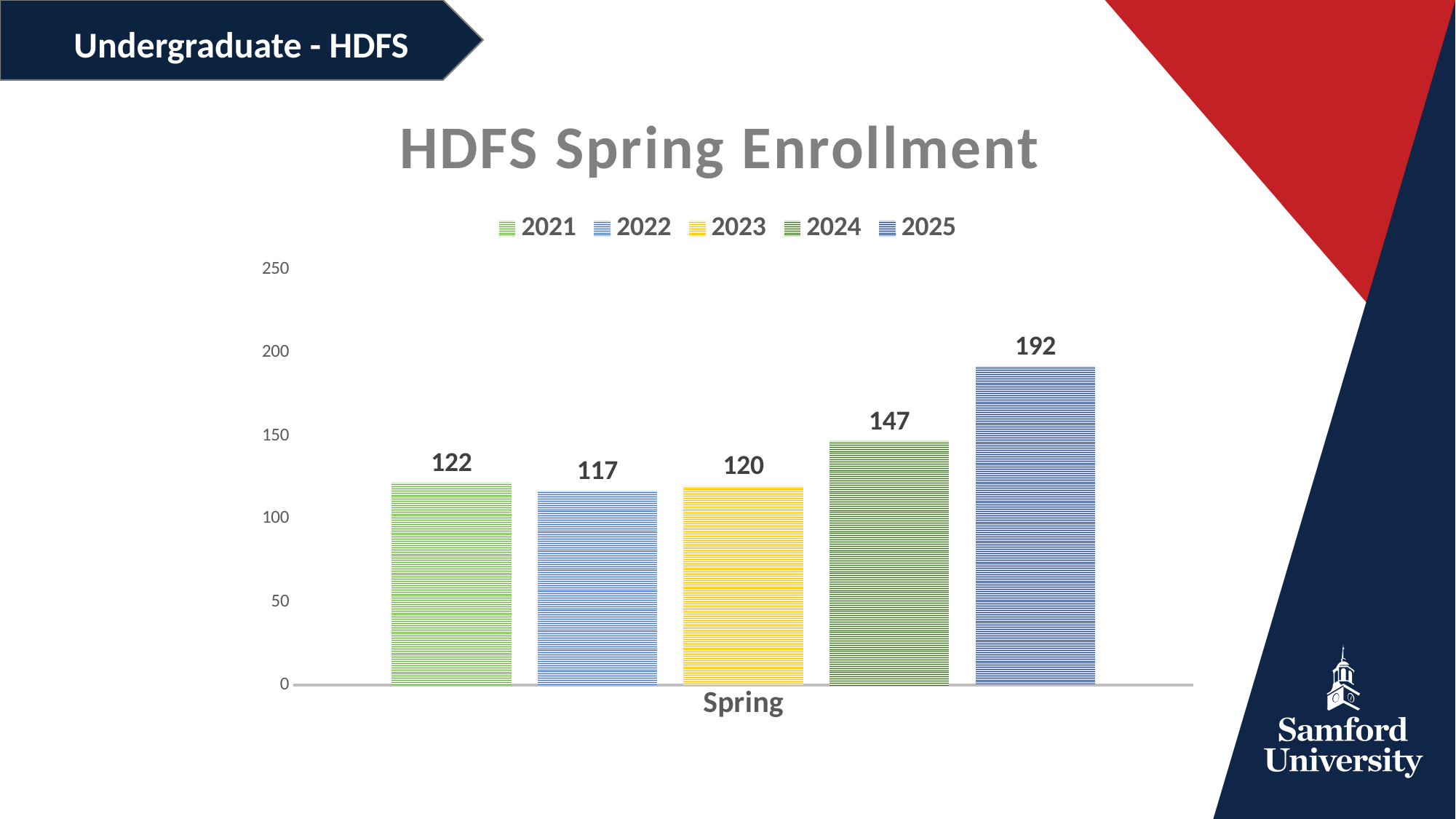
Is the HDFS Spring enrollment for 2024 greater or less than 150? less What is the difference in HDFS Spring enrollment between 2025 and 2024? 45 Which year has the lowest HDFS Spring enrollment? 2022 What is the HDFS Spring enrollment for 2024? 147 What is the difference in HDFS Spring enrollment between 2021 and 2023? 2 What is the HDFS Spring enrollment for 2022? 117 How many series does the legend list? 5 What kind of chart is shown on the slide? bar chart Which year has the highest HDFS Spring enrollment? 2025 What is the title of the chart? HDFS Spring Enrollment What is the HDFS Spring enrollment for 2025? 192 Which year has a larger HDFS Spring enrollment, 2021 or 2022? 2021